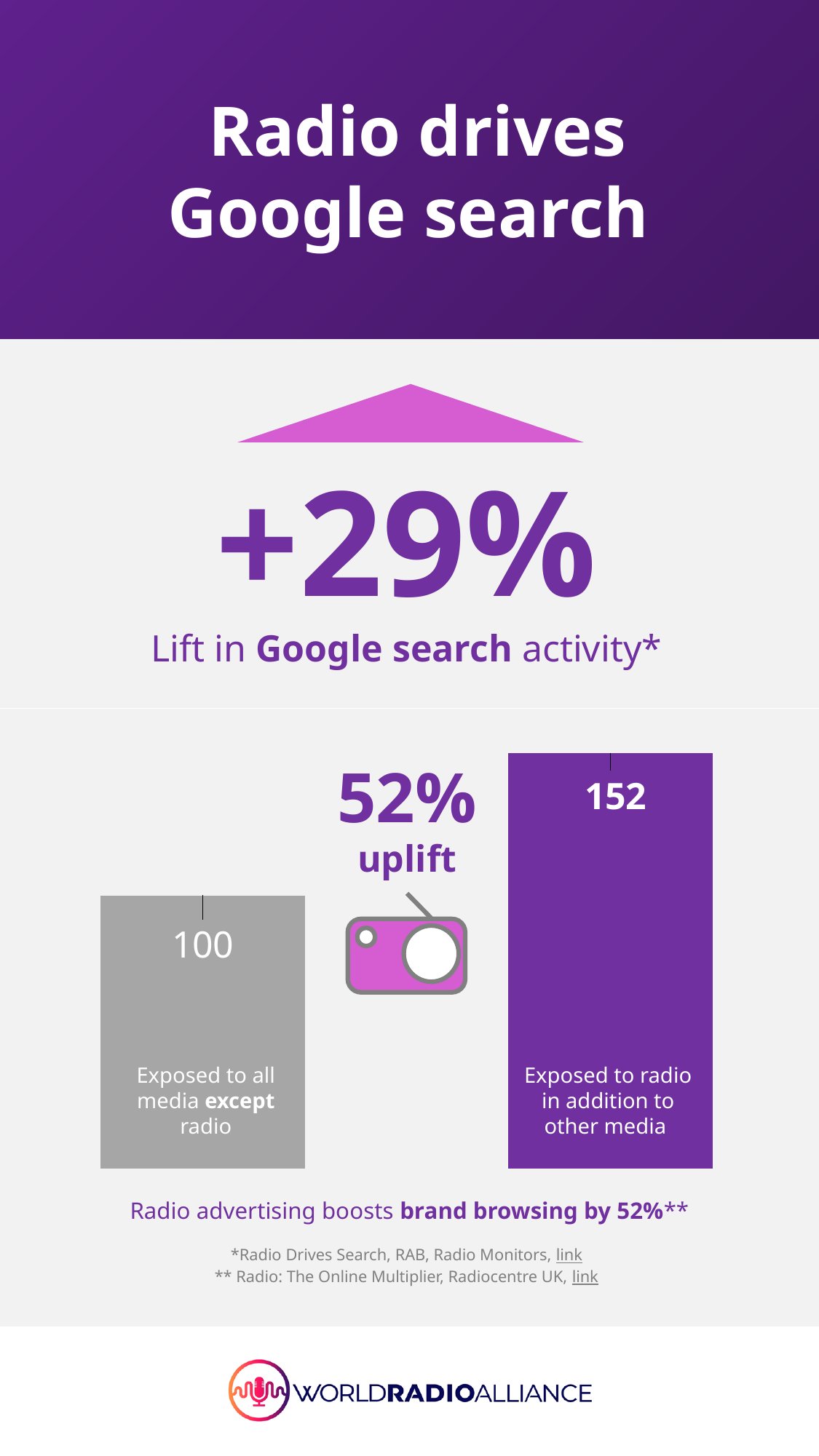
What kind of chart is shown on the slide? bar chart What is the title of the slide? Radio drives Google search What colour is the bar for 'Exposed to radio in addition to other media'? purple What uplift percentage is printed between the two bars? 52% Which bar is higher: 'Exposed to all media except radio' or 'Exposed to radio in addition to other media'? Exposed to radio in addition to other media What is the value for the bar labelled 'Exposed to all media except radio'? 100 What is the value for the bar labelled 'Exposed to radio in addition to other media'? 152 Is the value for 'Exposed to radio in addition to other media' larger or smaller than the value for 'Exposed to all media except radio'? larger What is the difference between the two bars, 152 and 100? 52 What lift in Google search activity is shown in the large figure above the chart? +29% Which bar has the lowest value? Exposed to all media except radio How many bars are shown in the chart? 2